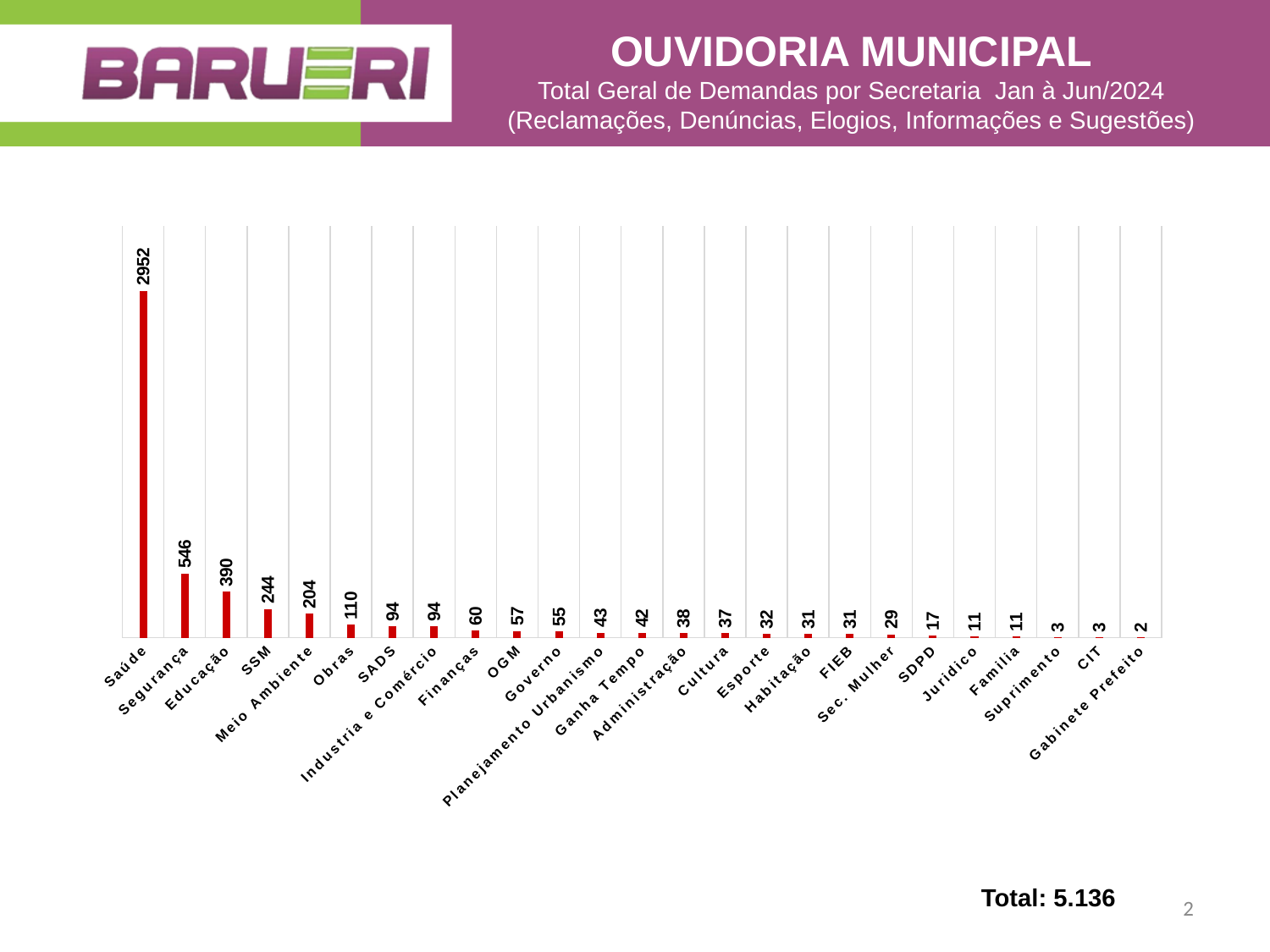
What is the value for Meio Ambiente? 204 What total is printed below the chart? 5.136 What is the value for Saúde? 2952 How many categories are shown on the x axis? 25 Which category has the highest value? Saúde Do the values rise or fall from left to right along the x axis? Fall What is the difference between the values for Segurança and Educação? 156 What is the value for Ganha Tempo? 42 What is the value for Segurança? 546 Which is larger, the value for Obras or the value for Finanças? Obras Which category has the lowest value? Gabinete Prefeito What kind of chart is shown on the slide? Bar chart